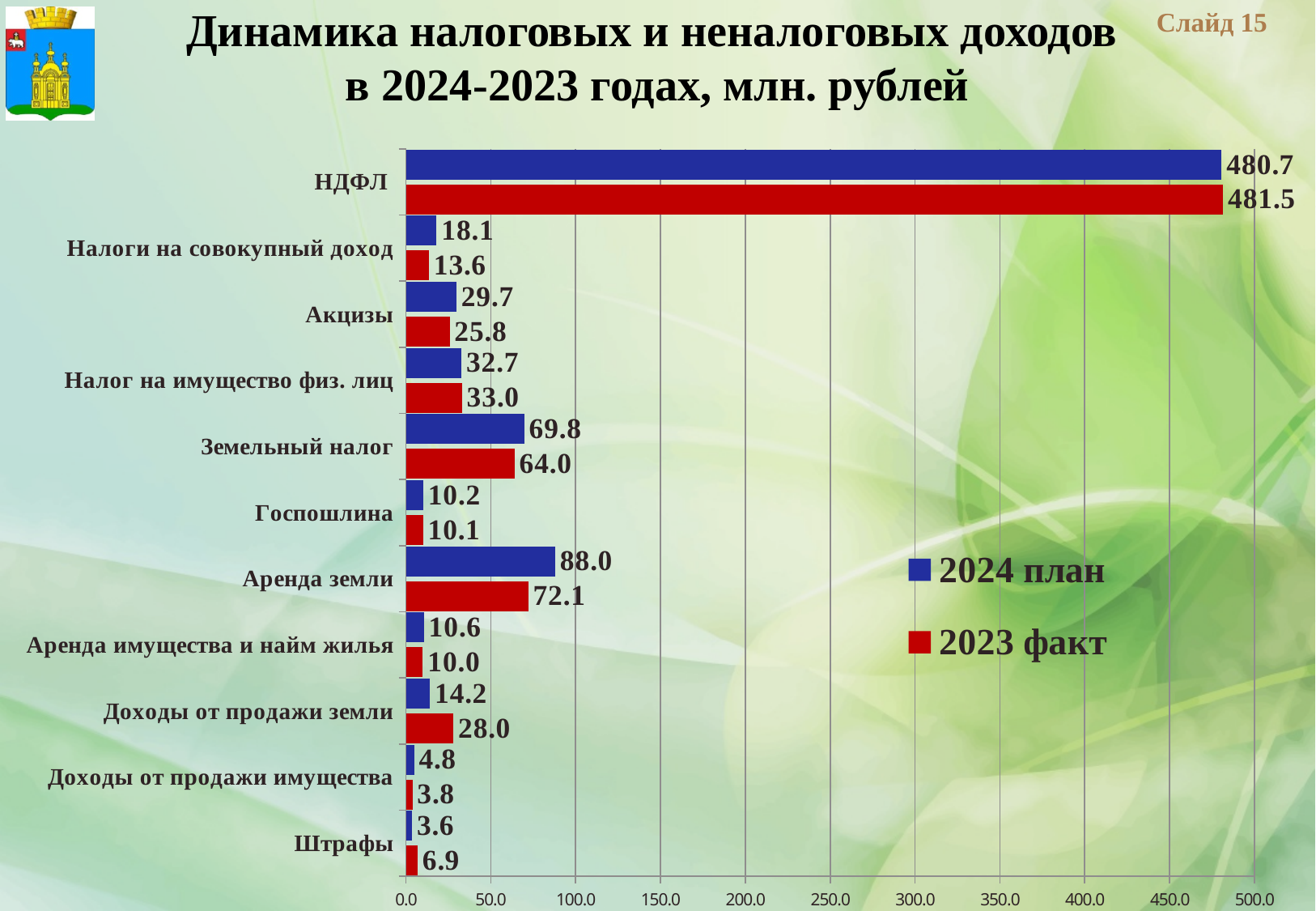
How many series does the legend list? 2 What is the difference between the 2024 план and 2023 факт values for Аренда земли? 15.9 Which category has the lowest 2024 план value? Штрафы Which category has the highest 2023 факт value? НДФЛ What is the 2024 план value for Доходы от продажи земли? 14.2 What kind of chart is shown on the slide? Bar chart What is the difference between the 2023 факт and 2024 план values for Штрафы? 3.3 What is the 2024 план value for НДФЛ? 480.7 What is the 2023 факт value for Аренда земли? 72.1 How many categories are shown on the chart? 11 Which is larger for Доходы от продажи земли: the 2024 план value or the 2023 факт value? 2023 факт Which colour represents the 2023 факт series in the legend? Red